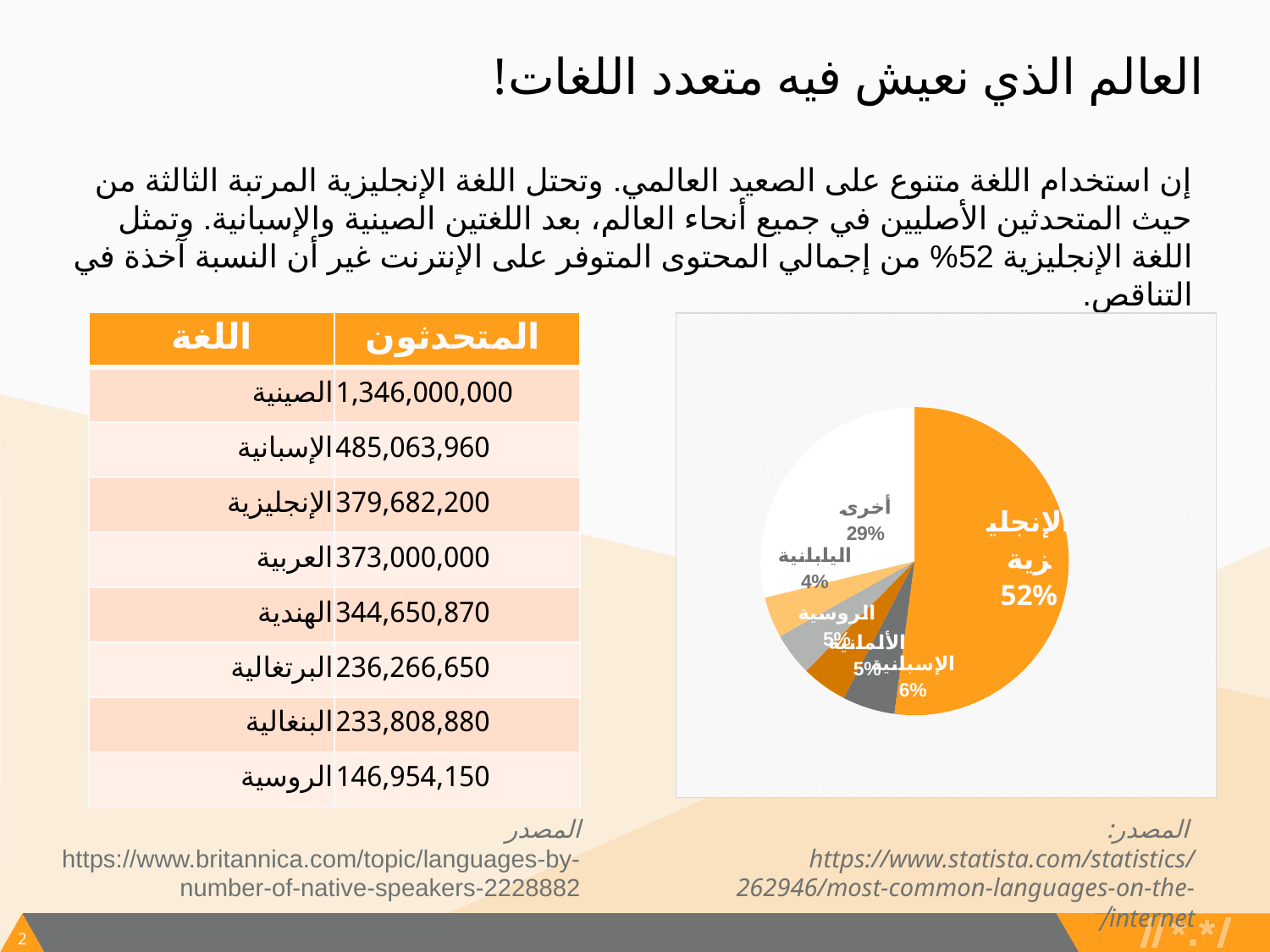
How many slices does the pie chart have? 6 In the pie chart, what is the difference between the share for أخرى and the share for اليابانية? 25% Which labelled slice of the pie chart is the smallest? اليابانية In the pie chart, what share is shown for اليابانية? 4% What colour is the الإنجليزية slice in the pie chart? orange What kind of chart is shown on the right side of the slide? pie chart In the pie chart, what share is shown for أخرى? 29% Which slice of the pie chart is the largest? الإنجليزية In the pie chart, which is larger: the share for الإنجليزية or the share for أخرى? الإنجليزية In the pie chart, what share is shown for الإنجليزية? 52% In the pie chart, what is the difference between the share for الإنجليزية and the share for أخرى? 23% In the pie chart, what share is shown for الإسبانية? 6%